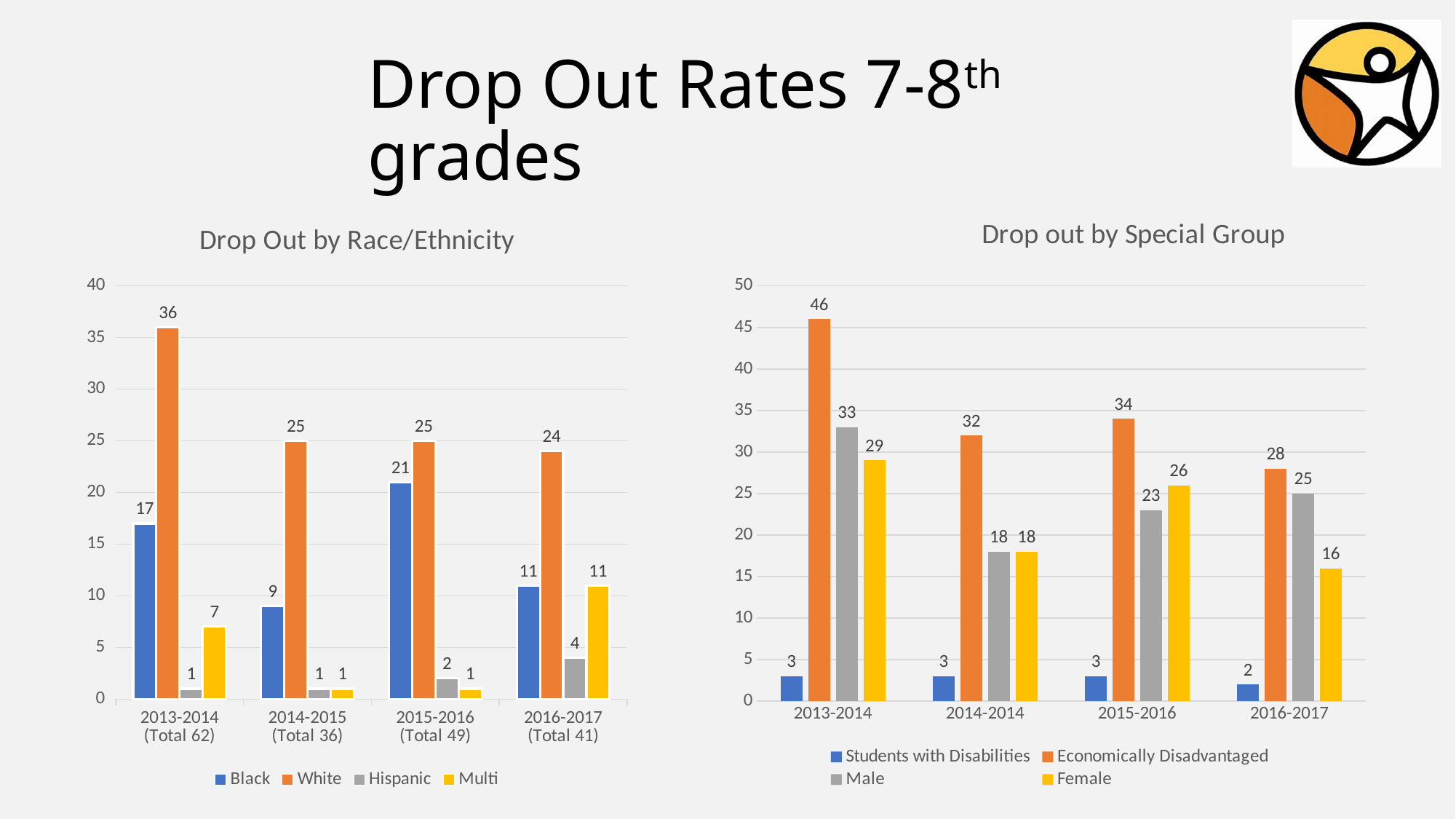
In the 'Drop Out by Race/Ethnicity' chart, what is the value for Black in 2015-2016? 21 In the 'Drop Out by Race/Ethnicity' chart, does the White value rise or fall from 2013-2014 to 2014-2015? fall In the 'Drop Out by Race/Ethnicity' chart, what is the difference between the White and Black values in 2013-2014? 19 In the 'Drop Out by Race/Ethnicity' chart, how many series does the legend list? 4 In the 'Drop out by Special Group' chart, which is larger in 2015-2016: Male or Female? Female In the 'Drop out by Special Group' chart, how many categories are shown on the x axis? 4 In the 'Drop out by Special Group' chart, what is the value for Female in 2016-2017? 16 In the 'Drop Out by Race/Ethnicity' chart, which category has the highest value for Multi? 2016-2017 (Total 41) What kind of chart is 'Drop out by Special Group'? bar chart In the 'Drop out by Special Group' chart, what is the value for Economically Disadvantaged in 2013-2014? 46 In the 'Drop out by Special Group' chart, which category has the lowest value for Students with Disabilities? 2016-2017 In the 'Drop Out by Race/Ethnicity' chart, what is the value for White in 2013-2014? 36